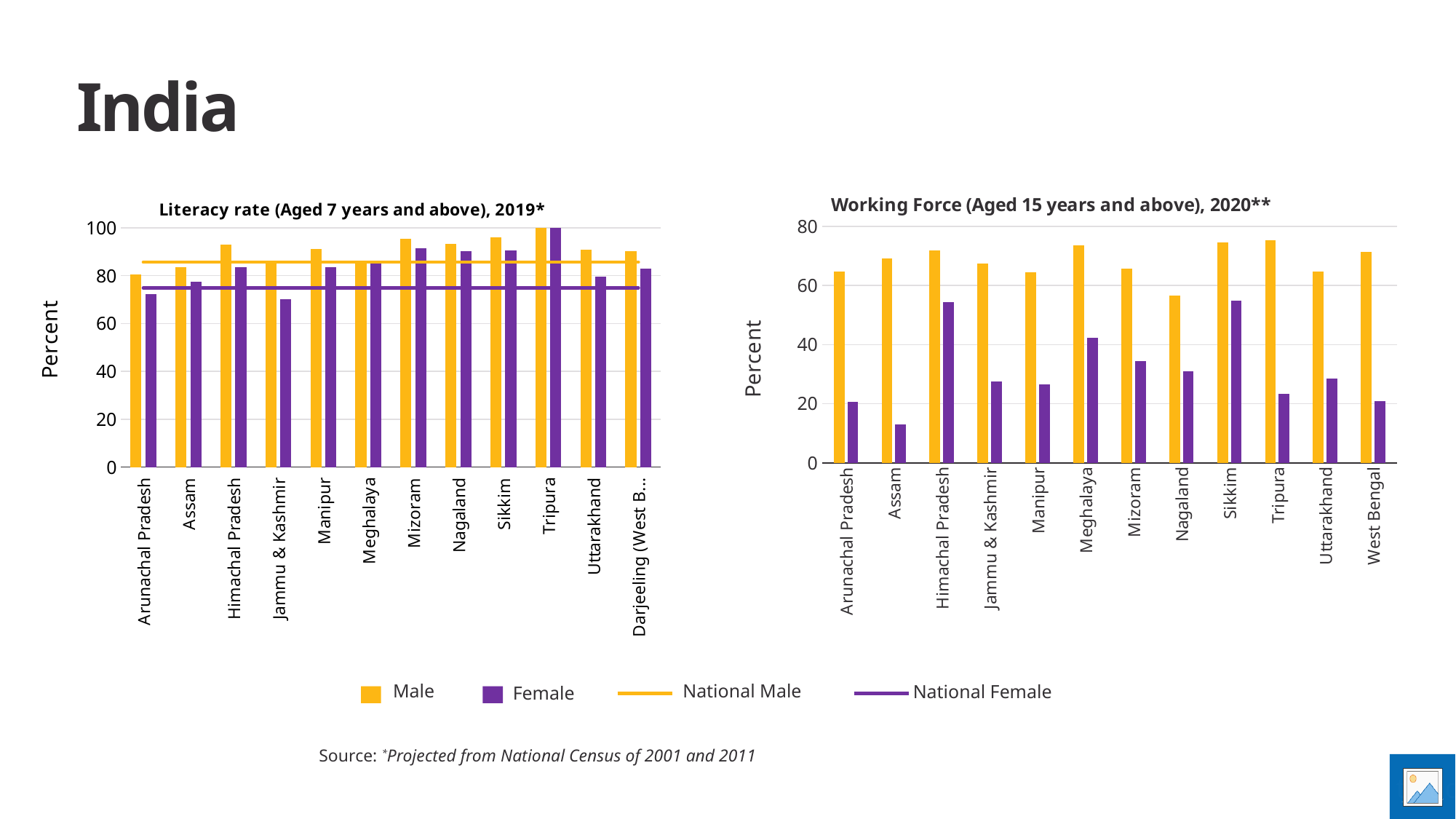
In the 'Working Force (Aged 15 years and above), 2020**' chart, is the Male value for Nagaland greater or less than 60? less In the 'Working Force (Aged 15 years and above), 2020**' chart, which state has the lowest Male value? Nagaland In the 'Literacy rate (Aged 7 years and above), 2019*' chart, is the Female value for Jammu & Kashmir greater or less than 80? less How many entries does the legend below the charts list? 4 In the 'Literacy rate (Aged 7 years and above), 2019*' chart, which state has the lowest Female value? Jammu & Kashmir What kind of chart is the 'Literacy rate (Aged 7 years and above), 2019*' chart? combination bar and line chart In the 'Literacy rate (Aged 7 years and above), 2019*' chart, which state has the highest Female value? Tripura How many states are shown on the x axis of the 'Working Force (Aged 15 years and above), 2020**' chart? 12 In the 'Working Force (Aged 15 years and above), 2020**' chart, is the Female value for Assam greater or less than 20? less In the 'Working Force (Aged 15 years and above), 2020**' chart, which is larger: the Female value for Himachal Pradesh or the Female value for Assam? Himachal Pradesh In the 'Working Force (Aged 15 years and above), 2020**' chart, which state has the lowest Female value? Assam What colour are the Female bars in the charts? purple